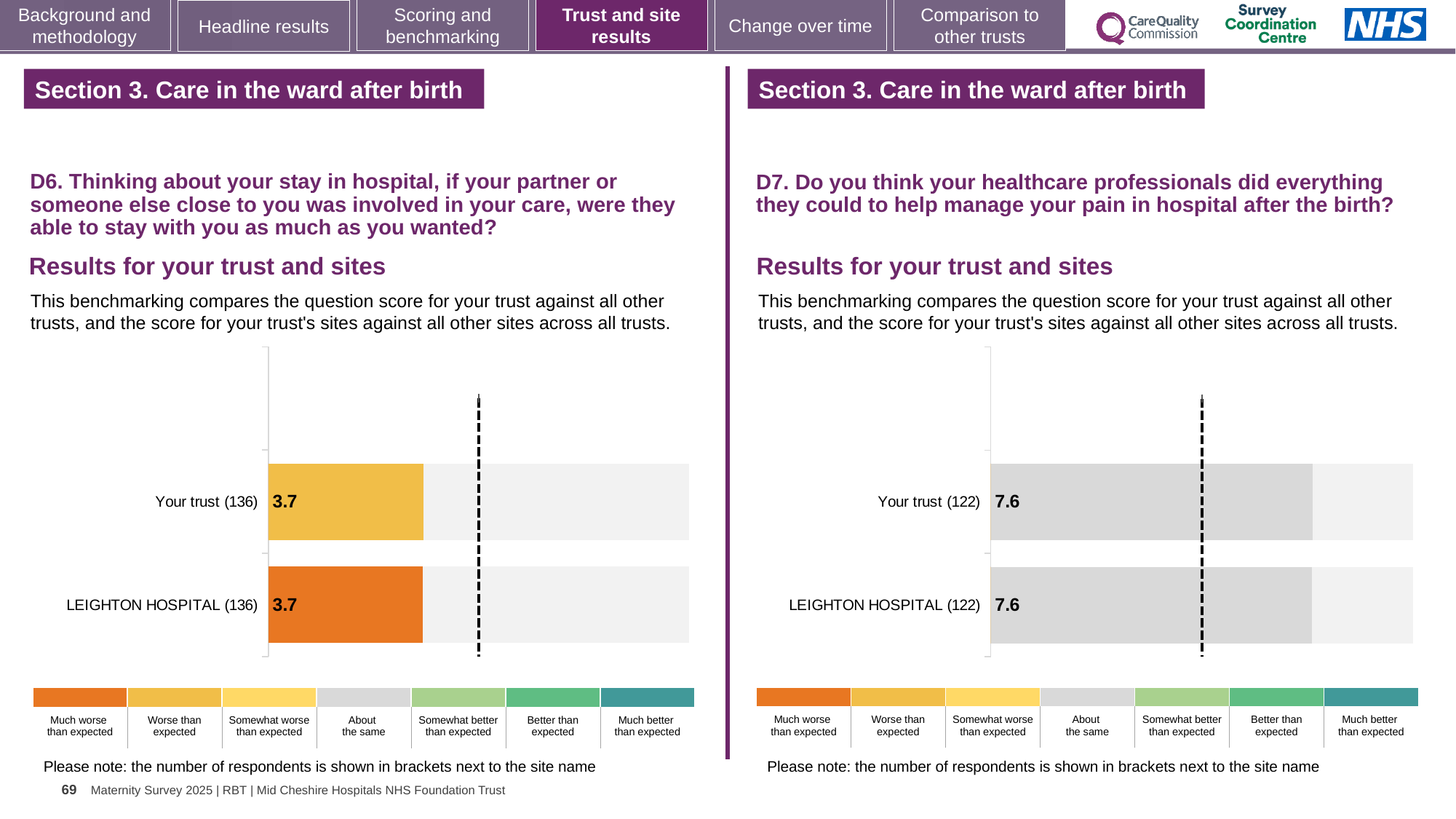
On the right chart (D7), what is the score for Your trust? 7.6 On the right chart (D7), which benchmarking category does the colour of the Your trust bar correspond to in the key? About the same On the left chart (D6), what is the difference between the score for Your trust and the score for LEIGHTON HOSPITAL? 0 On the left chart (D6), how many respondents are shown in brackets for Your trust? 136 On the right chart (D7), how many respondents are shown in brackets for LEIGHTON HOSPITAL? 122 On the left chart (D6), which benchmarking category does the colour of the LEIGHTON HOSPITAL bar correspond to in the key? Much worse than expected On the left chart (D6), what is the score for LEIGHTON HOSPITAL? 3.7 On the right chart (D7), what is the score for LEIGHTON HOSPITAL? 7.6 What kind of chart is used on the left (D6)? Bar chart How many bars are plotted on the right chart (D7)? 2 How many bars are plotted on the left chart (D6)? 2 On the left chart (D6), what is the score for Your trust? 3.7